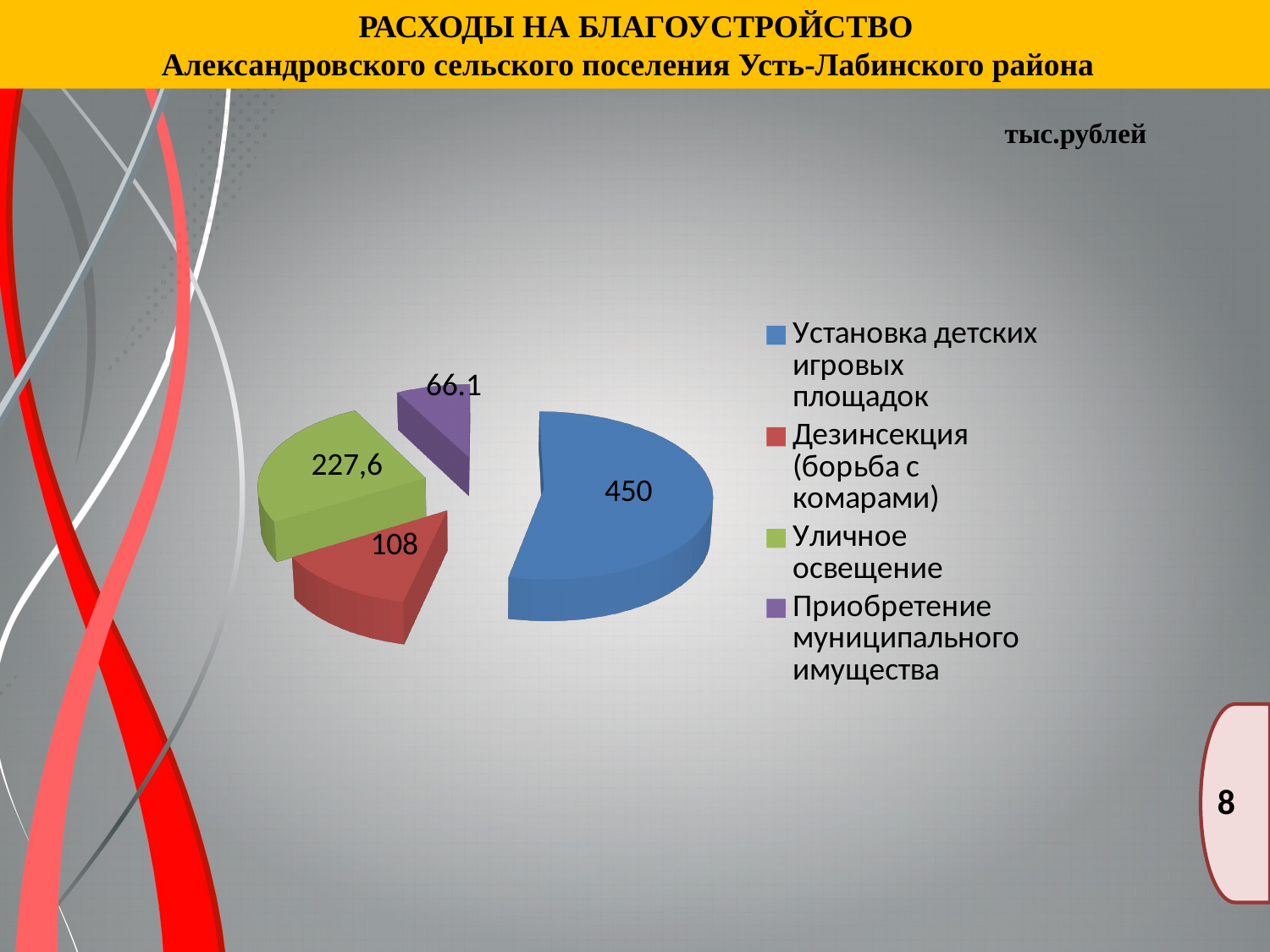
What is the value for Установка детских игровых площадок? 450 Which is larger: Уличное освещение or Дезинсекция (борьба с комарами)? Уличное освещение What kind of chart is shown on the slide? Pie chart What is the value for Приобретение муниципального имущества? 66.1 How many slices does the pie chart have? 4 Which category has the smallest value? Приобретение муниципального имущества What is the value for Дезинсекция (борьба с комарами)? 108 What is the total of all the slices in the pie chart? 851,7 Which category has the largest value? Установка детских игровых площадок What is the value for Уличное освещение? 227,6 What unit of measurement is indicated for the chart values? тыс.рублей What is the difference between the values for Установка детских игровых площадок and Дезинсекция (борьба с комарами)? 342